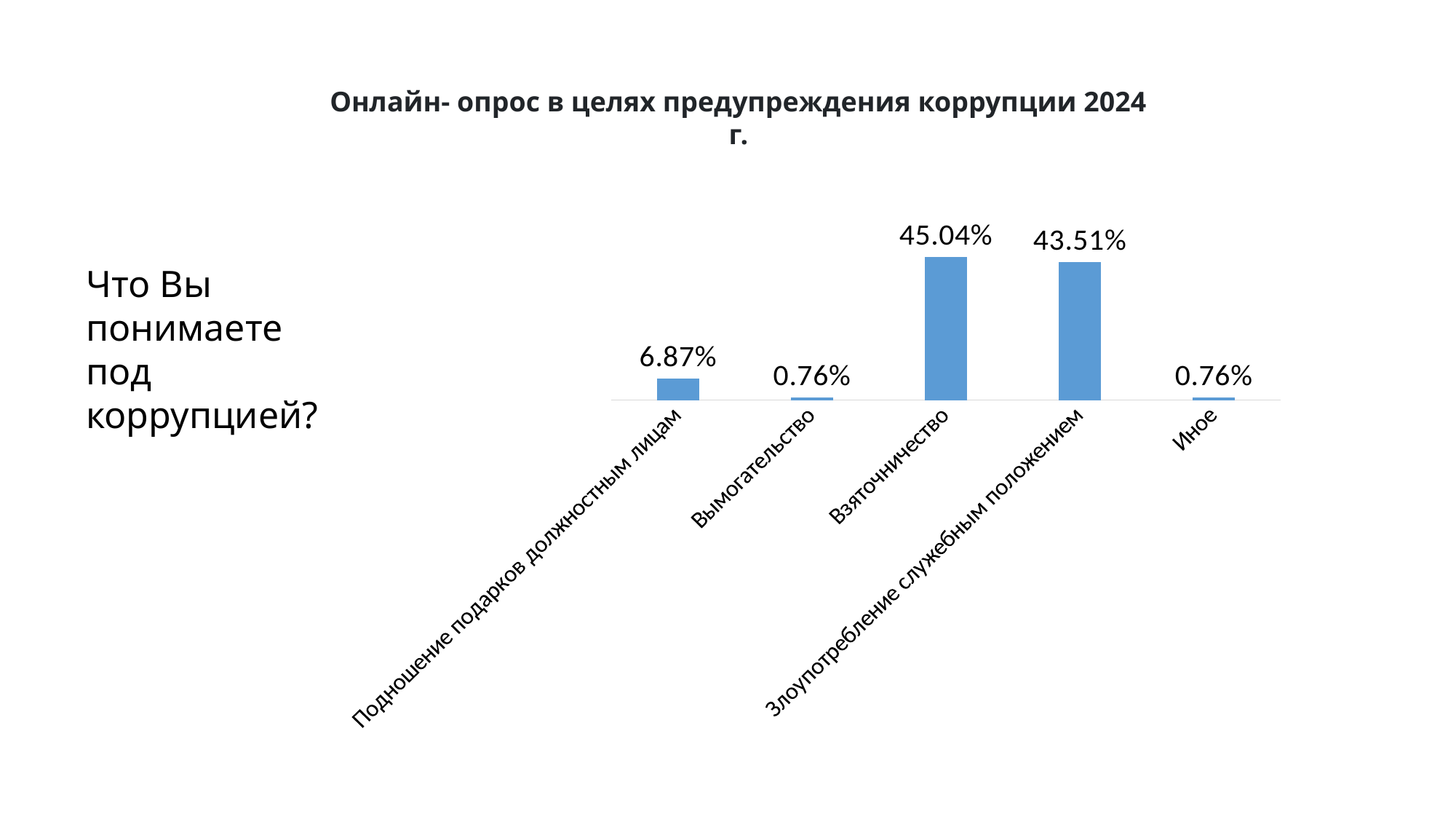
What is the difference between the values for Взяточничество and Злоупотребление служебным положением? 1.53% Which is larger, the value for Взяточничество or the value for Злоупотребление служебным положением? Взяточничество What is the difference between the values for Подношение подарков должностным лицам and Вымогательство? 6.11% What value is shown for Взяточничество? 45.04% What value is shown for Злоупотребление служебным положением? 43.51% What value is shown for Вымогательство? 0.76% What value is shown for Подношение подарков должностным лицам? 6.87% Which category has the highest value? Взяточничество How many categories are shown on the chart? 5 What value is shown for Иное? 0.76% What is the lowest value shown on the chart? 0.76% What kind of chart is shown on the slide? Bar chart